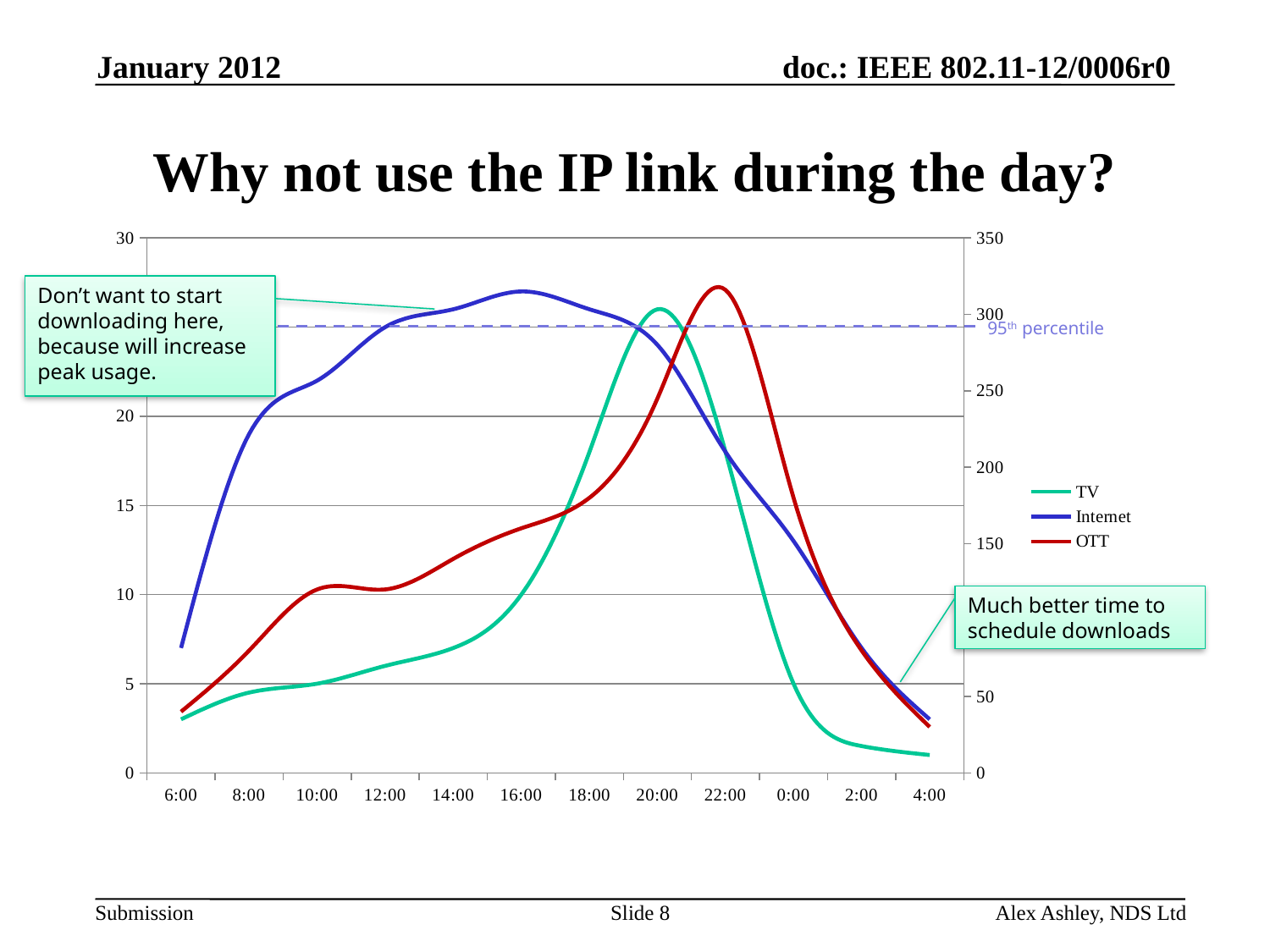
Which series reaches its peak latest in the day, around 22:00? OTT Does the OTT line rise or fall between 22:00 and 4:00? fall What are the three series named in the chart legend? TV, Internet, OTT At 2:00, which line is plotted lower on the chart, TV or OTT? TV How many series does the chart legend list? 3 Does the TV line rise or fall between 6:00 and 20:00? rise How many time labels are shown along the x axis of the chart? 12 At 6:00, which line is plotted higher on the chart, Internet or TV? Internet What colour is the OTT line in the chart? red What is the maximum value shown on the right-hand y axis of the chart? 350 What kind of chart is shown on the slide? line chart Which series reaches its peak earliest, around 16:00? Internet